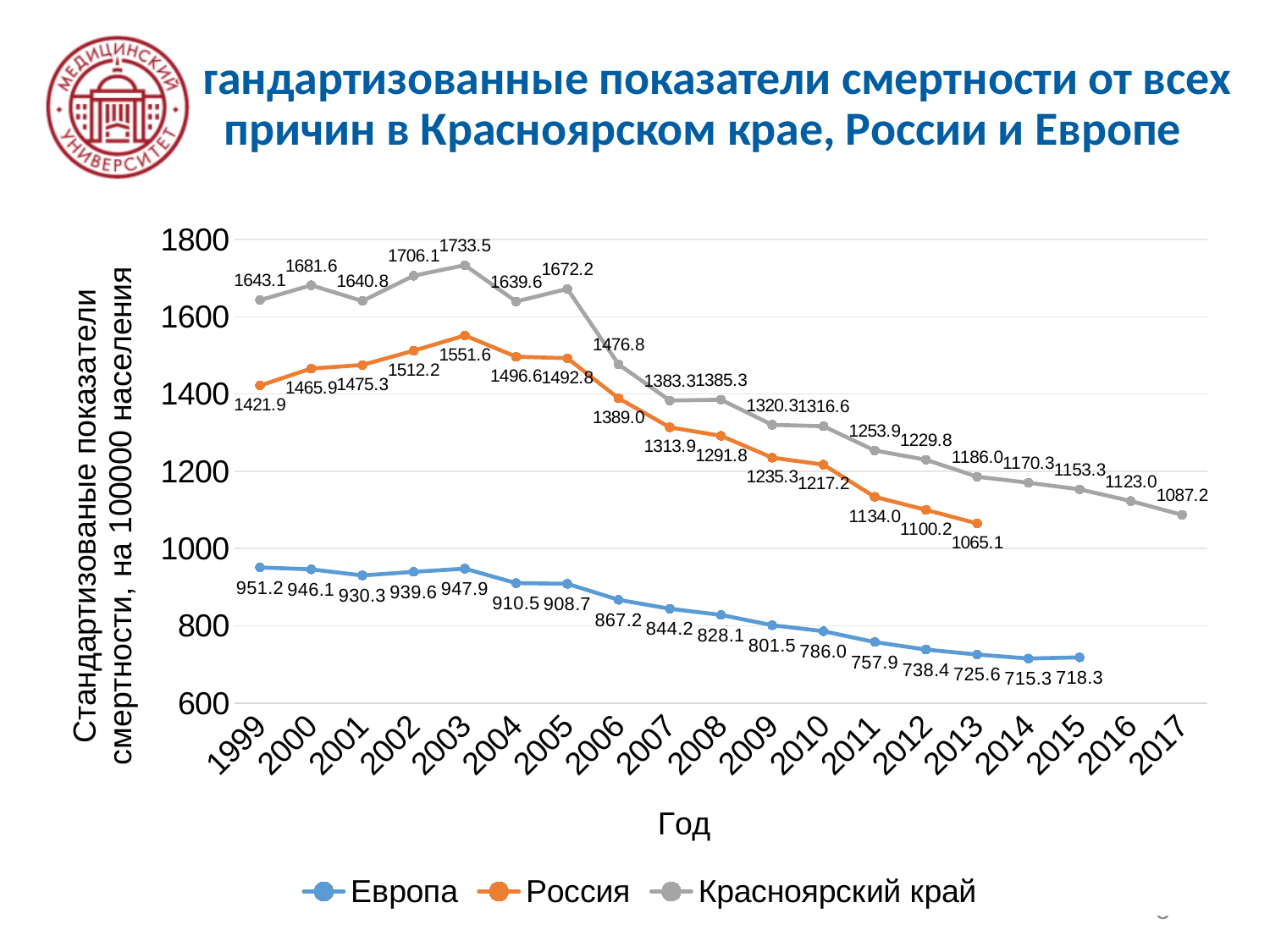
How many years are shown on the x axis? 19 What is the difference between the Красноярский край values for 1999 and 2017? 555.9 In 2010, which series has the larger value: Россия or Европа? Россия Does the Европа series rise or fall from 2005 to 2015? fall What kind of chart is shown on the slide? line chart What colour is the line for Россия? orange What is the value for Красноярский край in 2003? 1733.5 In which year does the Красноярский край series reach its highest value? 2003 How many series does the legend list? 3 In which year does the Европа series reach its lowest value? 2014 What is the value for Европа in 2015? 718.3 What is the value for Россия in 2013? 1065.1